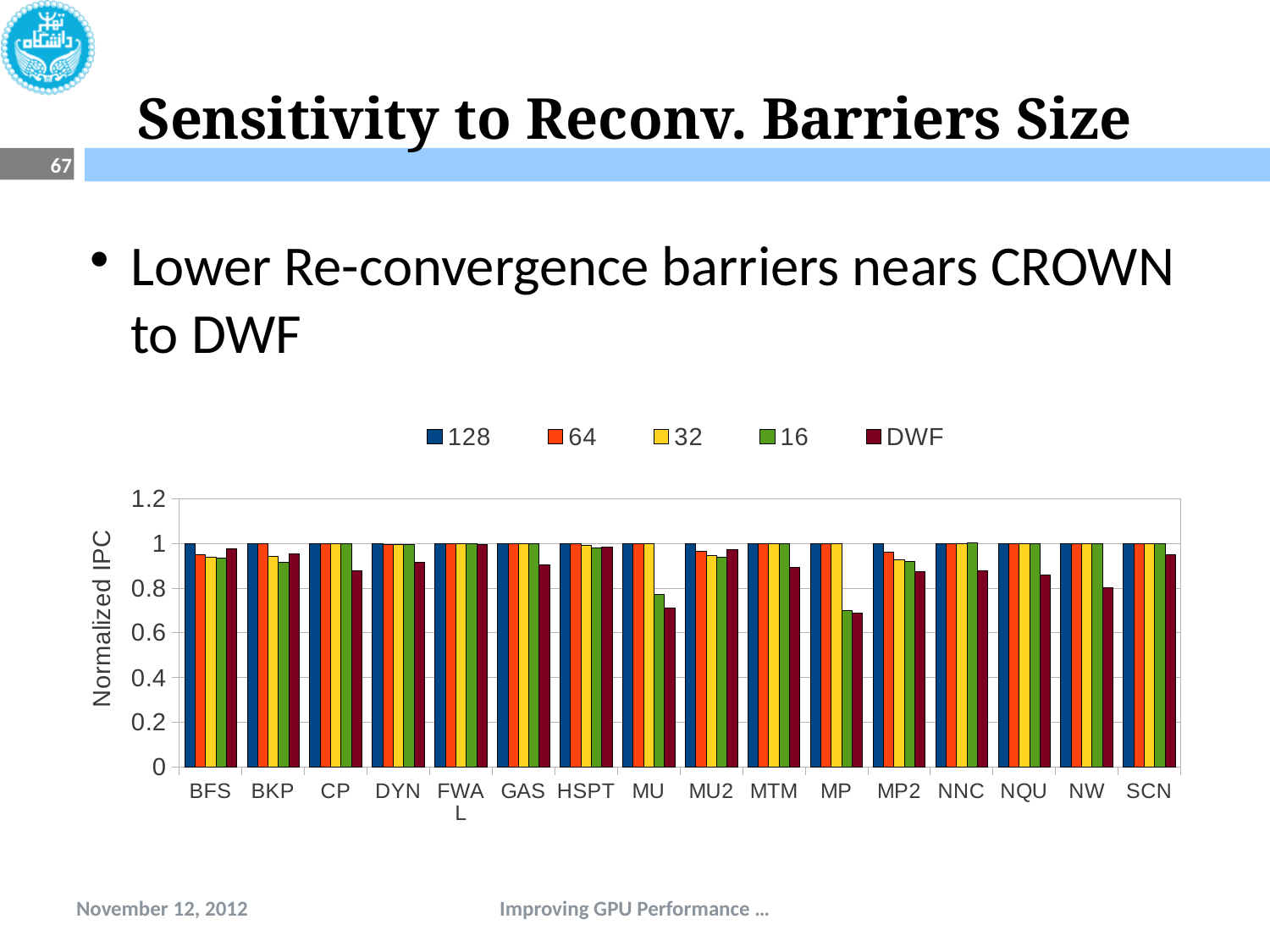
Which category has the lowest value for the 16 series? MP Which is larger, the 16 series value for MP or the 16 series value for BFS? BFS What kind of chart is shown on the slide? bar chart Is the DWF value for MU greater or less than 0.8? less Which is larger, the DWF value for MU or the DWF value for SCN? SCN Which series is listed last in the legend? DWF Is the DWF value for MP greater or less than 0.8? less What is the label of the y axis? Normalized IPC Is the DWF value for CP greater or less than 0.8? greater How many benchmark categories are shown along the x axis? 16 How many series does the legend list? 5